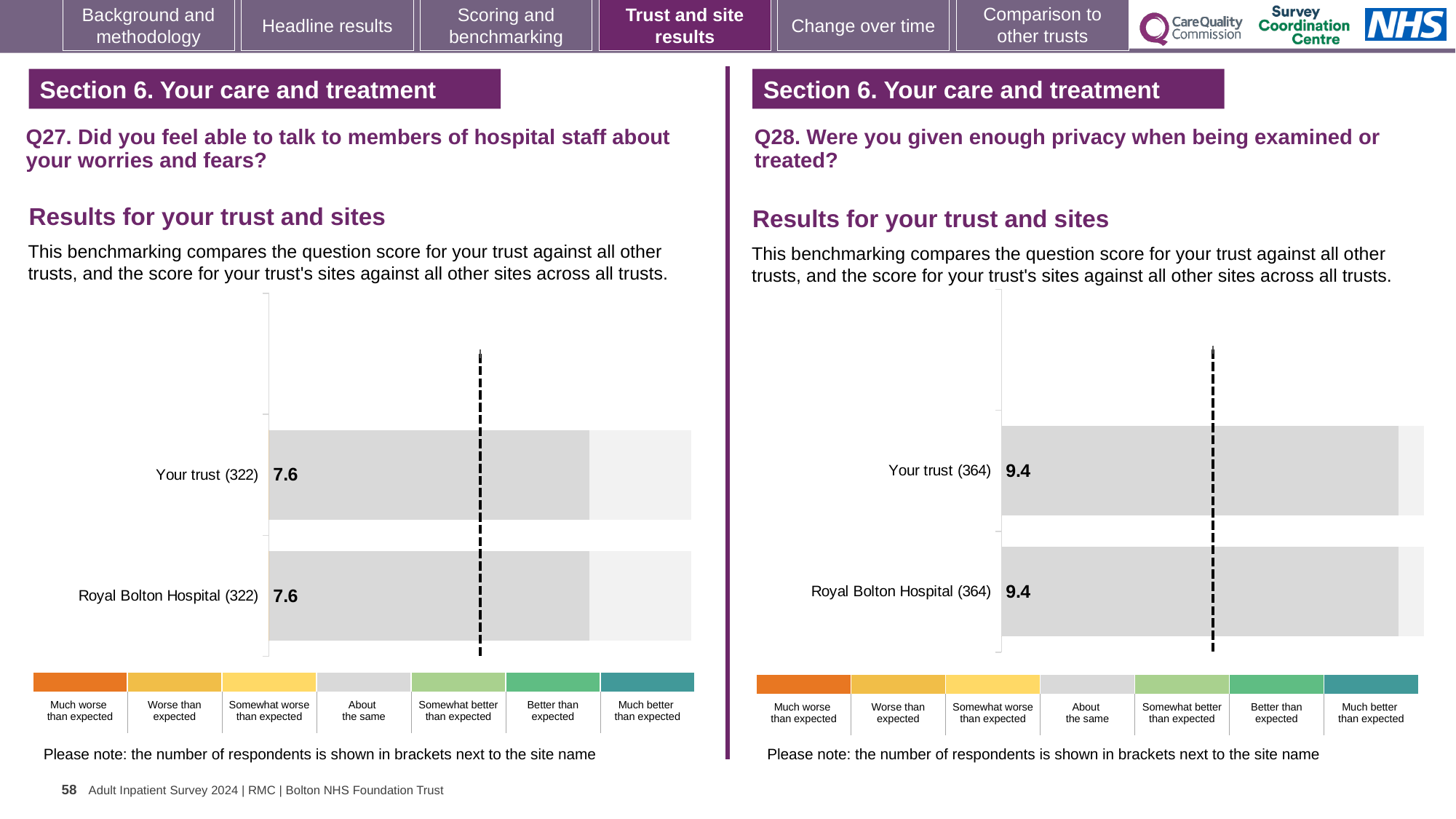
In the Q28 chart on the right, how many respondents are shown in brackets next to Royal Bolton Hospital? 364 In the Q27 chart on the left, what is the difference between the score for Your trust and the score for Royal Bolton Hospital? 0 Is the score for Your trust higher in the Q27 chart on the left or in the Q28 chart on the right? Q28 chart on the right In the Q27 chart on the left, what is the score for Royal Bolton Hospital? 7.6 In the Q27 chart on the left, how many respondents are shown in brackets next to Your trust? 322 How many bars are plotted in the Q28 chart on the right? 2 In the Q27 chart on the left, what is the score for Your trust? 7.6 In the Q28 chart on the right, what is the score for Royal Bolton Hospital? 9.4 In the Q28 chart on the right, what is the score for Your trust? 9.4 How many benchmark categories are shown in the colour key below the Q28 chart on the right? 7 What type of chart is used for the Q27 results on the left? Bar chart